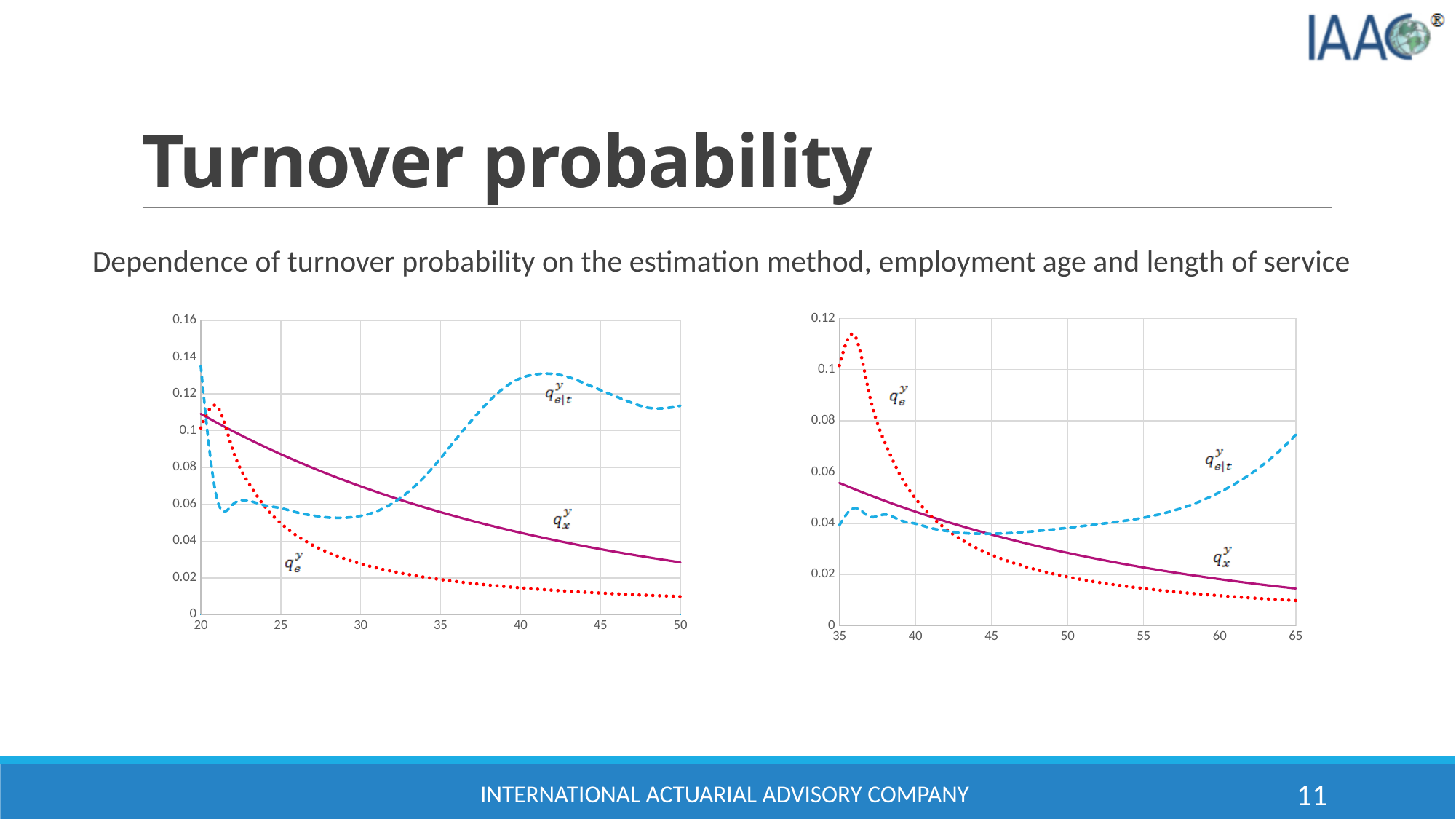
On the left chart, does the solid q_x line rise or fall as age increases from 20 to 50? fall What kind of chart is the left chart on the slide? line chart On the left chart, is the value of the dotted q_s line at age 50 greater or less than 0.02? less On the left chart, is the peak of the dashed q_s|t line around age 41 greater or less than 0.12? greater On the right chart, at age 60, which is larger: the dashed q_s|t line or the dotted q_s line? q_s|t On the left chart, is the value of the solid q_x line at age 50 greater or less than 0.04? less How many series are plotted on the right chart? 3 What is the range of the x axis on the right chart? 35 to 65 On the left chart, at age 45, which is larger: the dashed q_s|t line or the solid q_x line? q_s|t